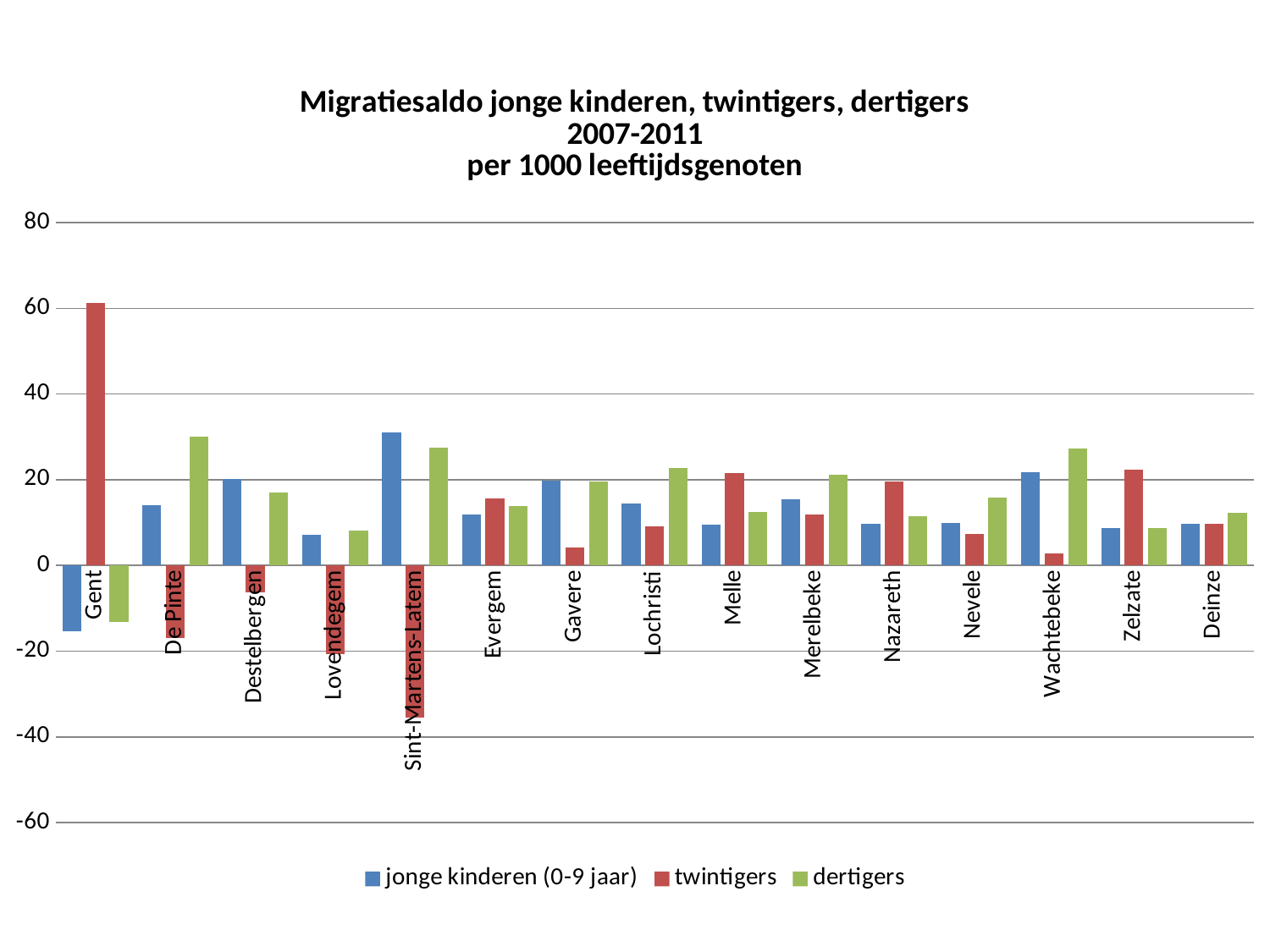
Which municipality has the highest value for jonge kinderen (0-9 jaar)? Sint-Martens-Latem What kind of chart is shown on the slide? bar chart How many series does the legend list? 3 Is the value for twintigers in Gent greater or less than 40? greater Which municipality has the highest value for twintigers? Gent Which municipality has the lowest value for dertigers? Gent How many municipalities are shown along the x axis? 15 Is the value for twintigers in Sint-Martens-Latem greater or less than -20? less How many municipalities have a negative value for twintigers? 4 Which municipality has the lowest value for twintigers? Sint-Martens-Latem Is the value for jonge kinderen (0-9 jaar) in Gent greater or less than 0? less In Wachtebeke, which is larger: the value for dertigers or the value for twintigers? dertigers